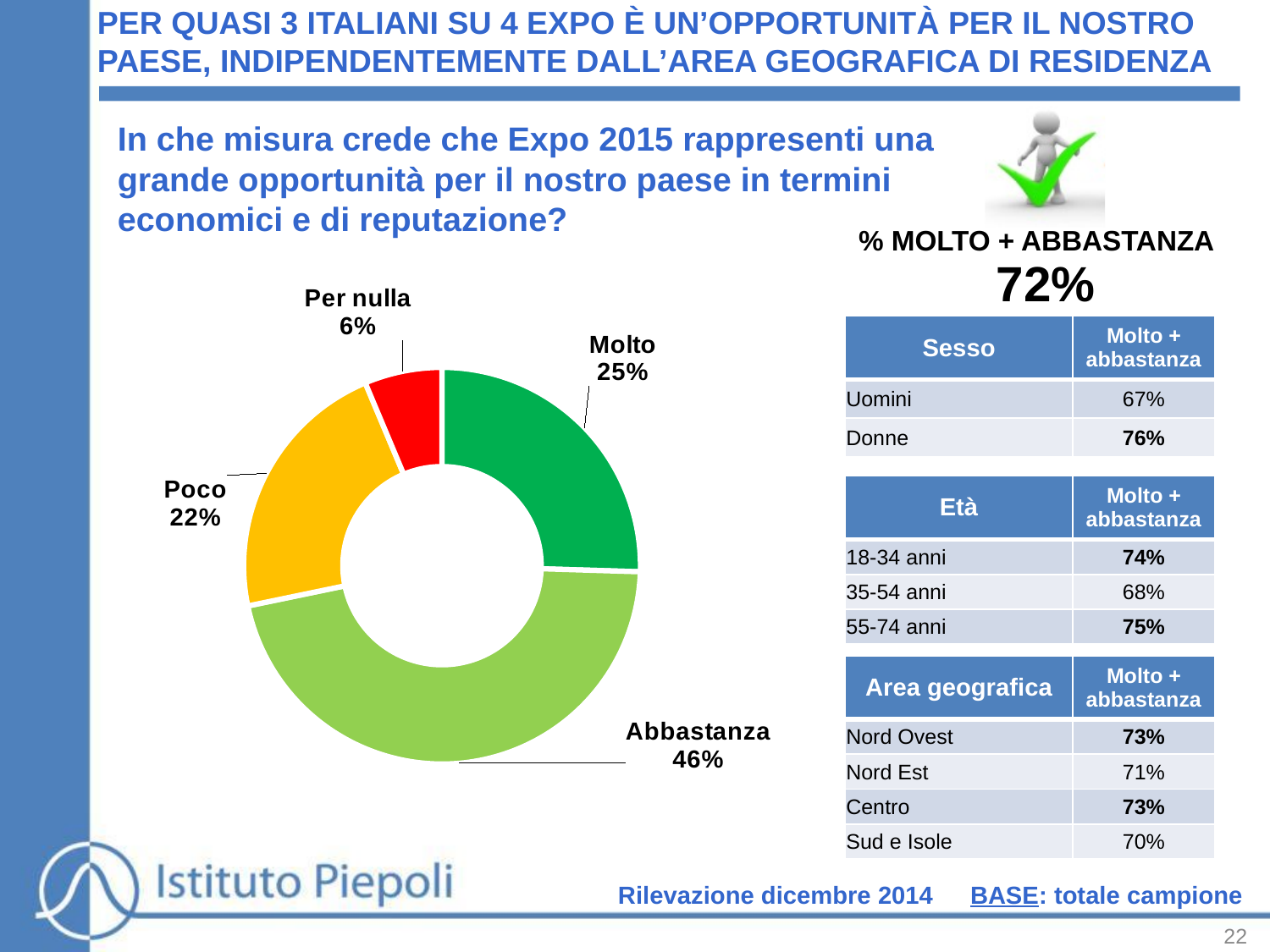
Which is larger, the share for "Molto" or the share for "Poco"? Molto What type of chart is used to show the response distribution? Doughnut (pie) chart What is the value shown for "Per nulla"? 6% What percentage of respondents answered "Molto"? 25% How many response categories are shown in the doughnut chart? 4 Which response category has the smallest share of the doughnut chart? Per nulla Which response category has the largest share of the doughnut chart? Abbastanza What percentage of respondents answered "Abbastanza" in the doughnut chart? 46% What colour is the "Per nulla" slice of the doughnut chart? Red What is the value shown for "Poco"? 22% What is the difference in percentage points between "Abbastanza" and "Molto"? 21